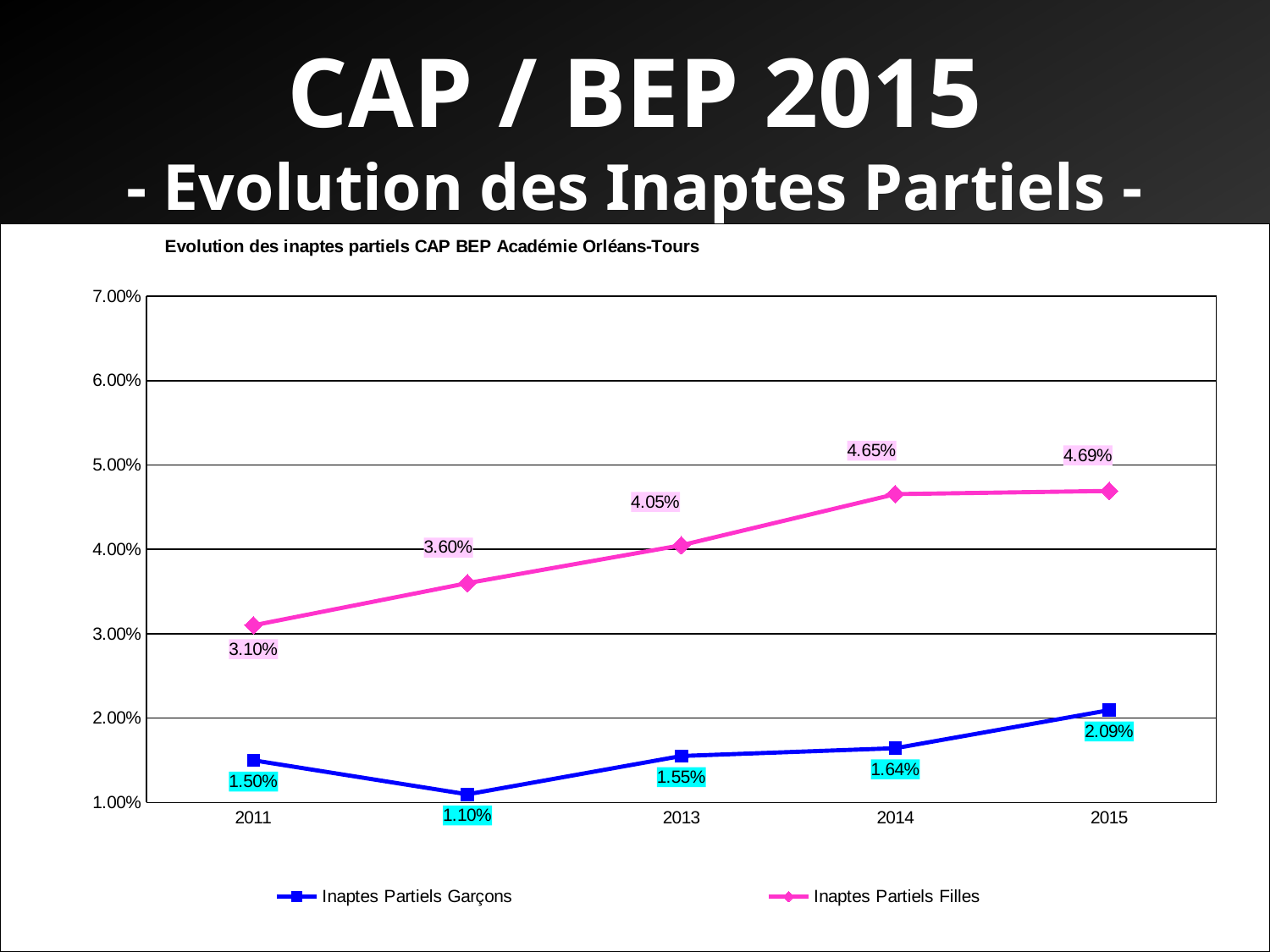
In which year is the Inaptes Partiels Filles value highest? 2015 Is the value for Inaptes Partiels Garçons in 2014 greater or less than 2.00%? less What kind of chart is shown on the slide? line chart What is the value for Inaptes Partiels Filles in 2013? 4.05% How many series does the legend list? 2 What is the lowest value plotted for Inaptes Partiels Garçons? 1.10% What is the difference between the Inaptes Partiels Filles and Inaptes Partiels Garçons values in 2015? 2.60% By how much did the Inaptes Partiels Filles value increase from 2011 to 2014? 1.55% In 2014, which series has the larger value, Inaptes Partiels Garçons or Inaptes Partiels Filles? Inaptes Partiels Filles What is the value for Inaptes Partiels Garçons in 2015? 2.09% How many years are plotted on the x axis? 5 What is the value for Inaptes Partiels Filles in 2011? 3.10%